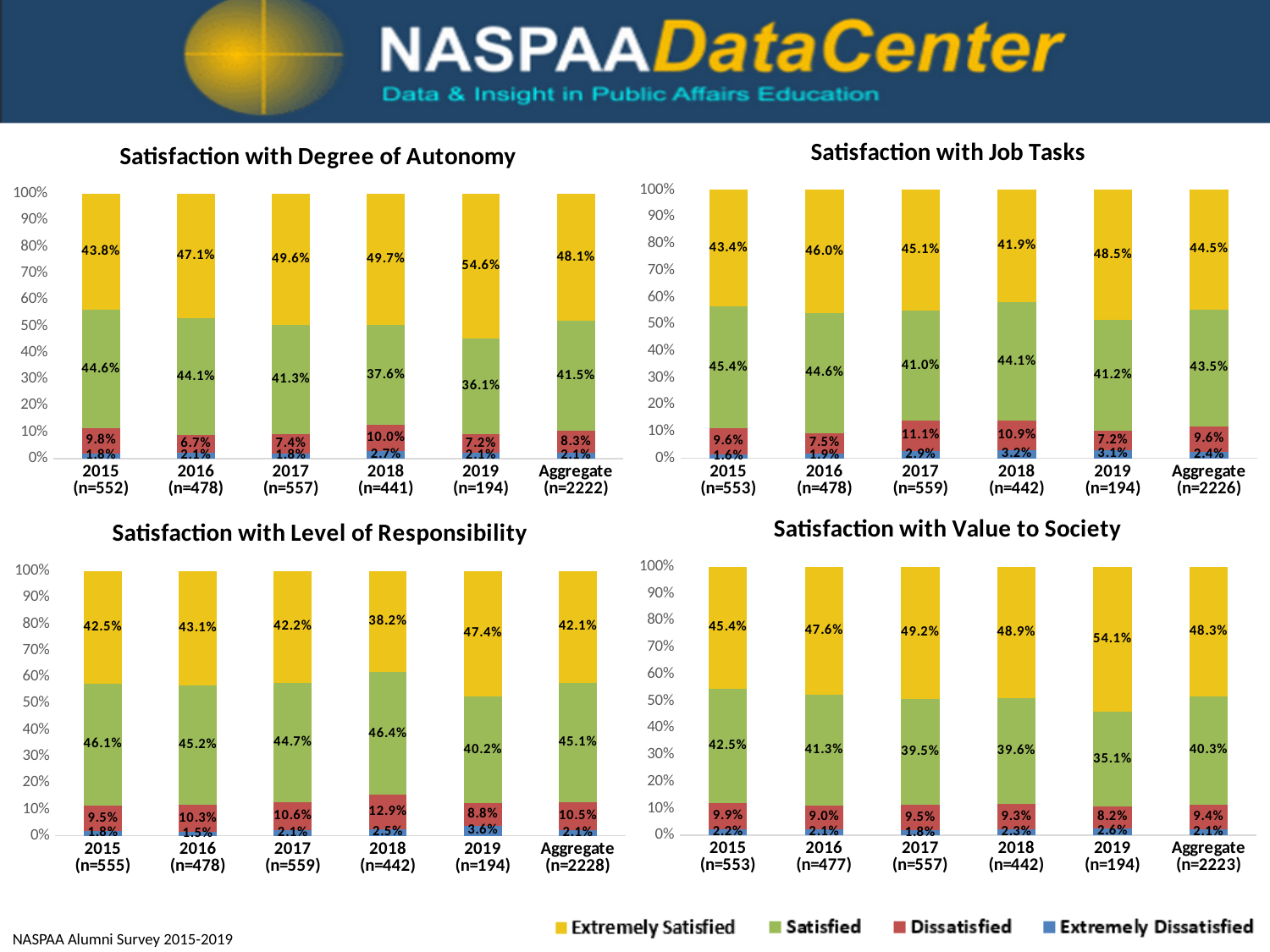
How many bars are shown in the 'Satisfaction with Job Tasks' chart? 6 In the 'Satisfaction with Level of Responsibility' chart, what is the Satisfied value for 2018? 46.4% In the 'Satisfaction with Degree of Autonomy' chart, what is the Extremely Satisfied value for 2019? 54.6% In the 'Satisfaction with Job Tasks' chart, what is the Dissatisfied value for 2017? 11.1% In the 'Satisfaction with Value to Society' chart, what is the difference between the Extremely Satisfied values for 2019 and 2015? 8.7% What kind of chart is 'Satisfaction with Degree of Autonomy'? Stacked bar chart In the 'Satisfaction with Degree of Autonomy' chart, which year has the highest Extremely Satisfied value? 2019 In the 'Satisfaction with Value to Society' chart, does the Satisfied value rise or fall from 2015 to 2019? Fall In the 'Satisfaction with Level of Responsibility' chart, which year has the lowest Extremely Satisfied value? 2018 How many series does the legend list? 4 In the 'Satisfaction with Job Tasks' chart, which is larger for 2018: the Extremely Satisfied value or the Satisfied value? Satisfied In the 'Satisfaction with Value to Society' chart, what is the Extremely Dissatisfied value for the Aggregate bar? 2.1%